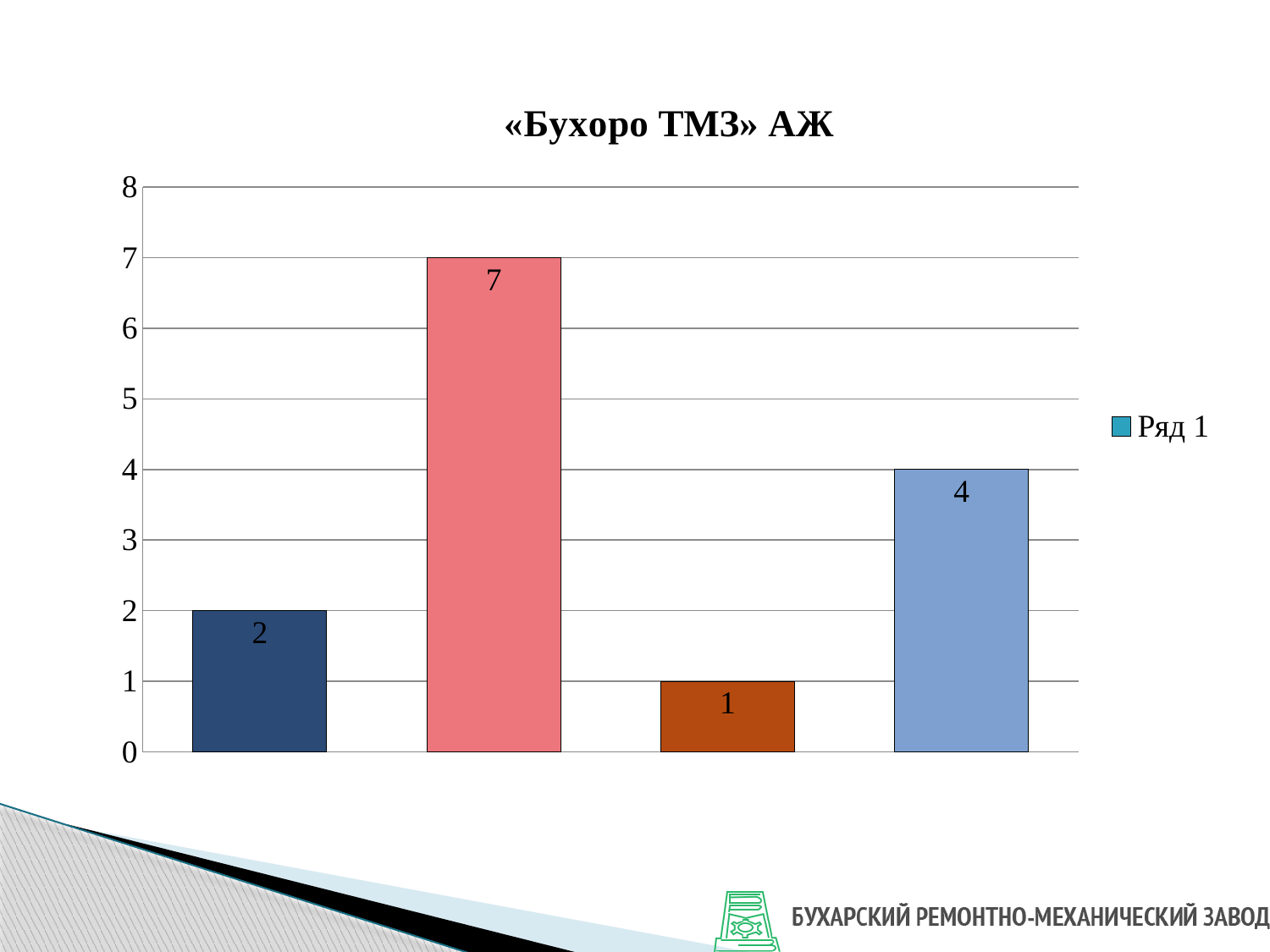
What is the value of the fourth (rightmost, light blue) bar? 4 How many series does the legend list? 1 What is the value of the first (leftmost, dark blue) bar? 2 Which bar has the highest value? the second (pink) bar, 7 What is the title of the chart? «Бухоро ТМЗ» АЖ What is the difference between the value of the second bar and the value of the fourth bar? 3 What is the value of the third (orange-brown) bar? 1 What is the value of the second (pink) bar? 7 What type of chart is shown on the slide? bar chart Which bar has the lowest value? the third (orange-brown) bar, 1 How many bars are plotted in the chart? 4 What is the name of the series shown in the legend? Ряд 1